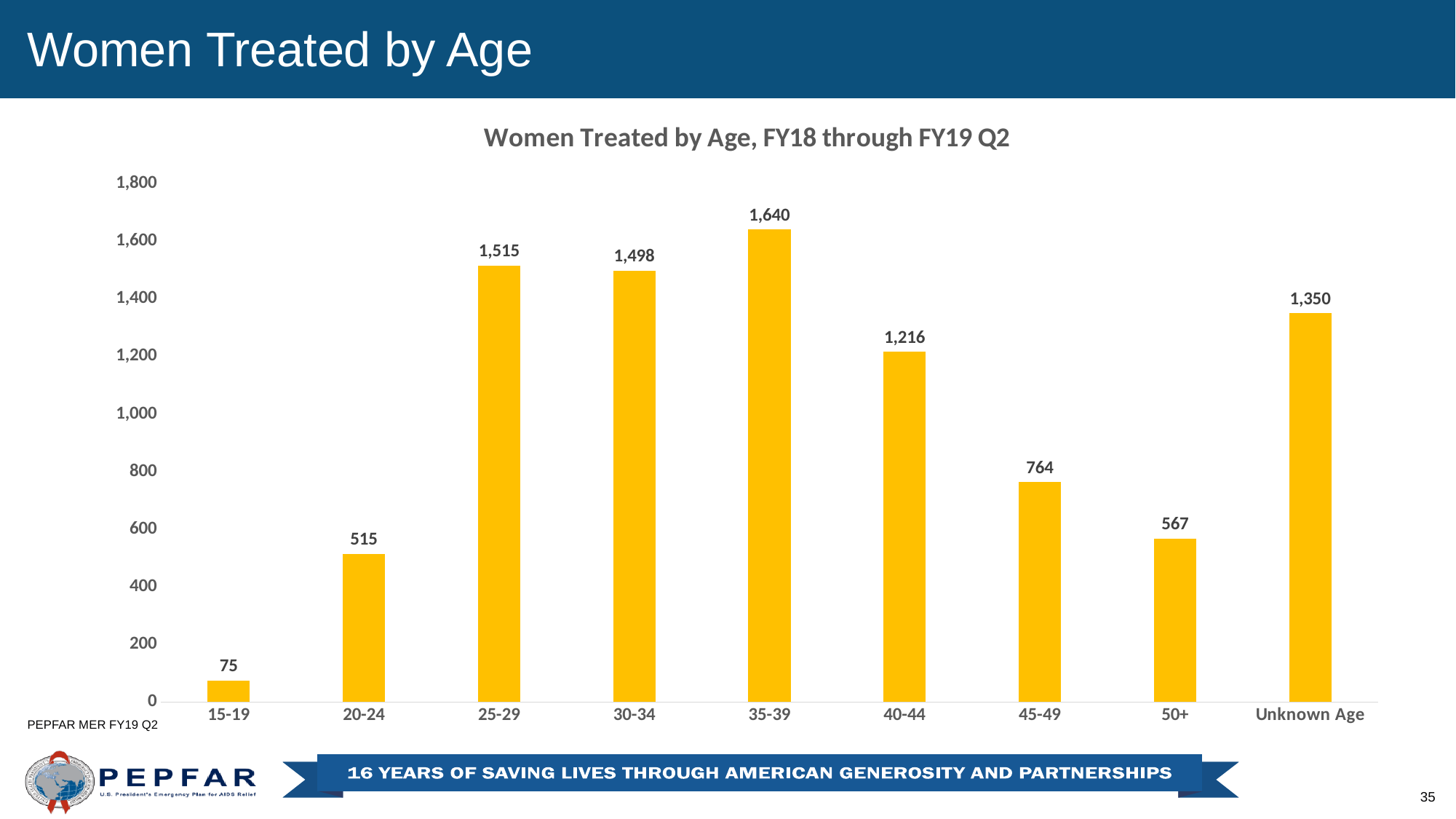
Which age category has the highest value? 35-39 Is the value for 40-44 greater or less than 1,000? greater What is the title of the chart? Women Treated by Age, FY18 through FY19 Q2 What is the value for the 35-39 age group? 1,640 What is the difference between the values for 40-44 and 45-49? 452 What is the difference between the values for 25-29 and 30-34? 17 What is the value for the 50+ age group? 567 Which age category has the lowest value? 15-19 What kind of chart is shown on the slide? Bar chart What is the value for the Unknown Age category? 1,350 Which is larger, the value for 20-24 or the value for 50+? 50+ How many age categories are shown on the x axis? 9